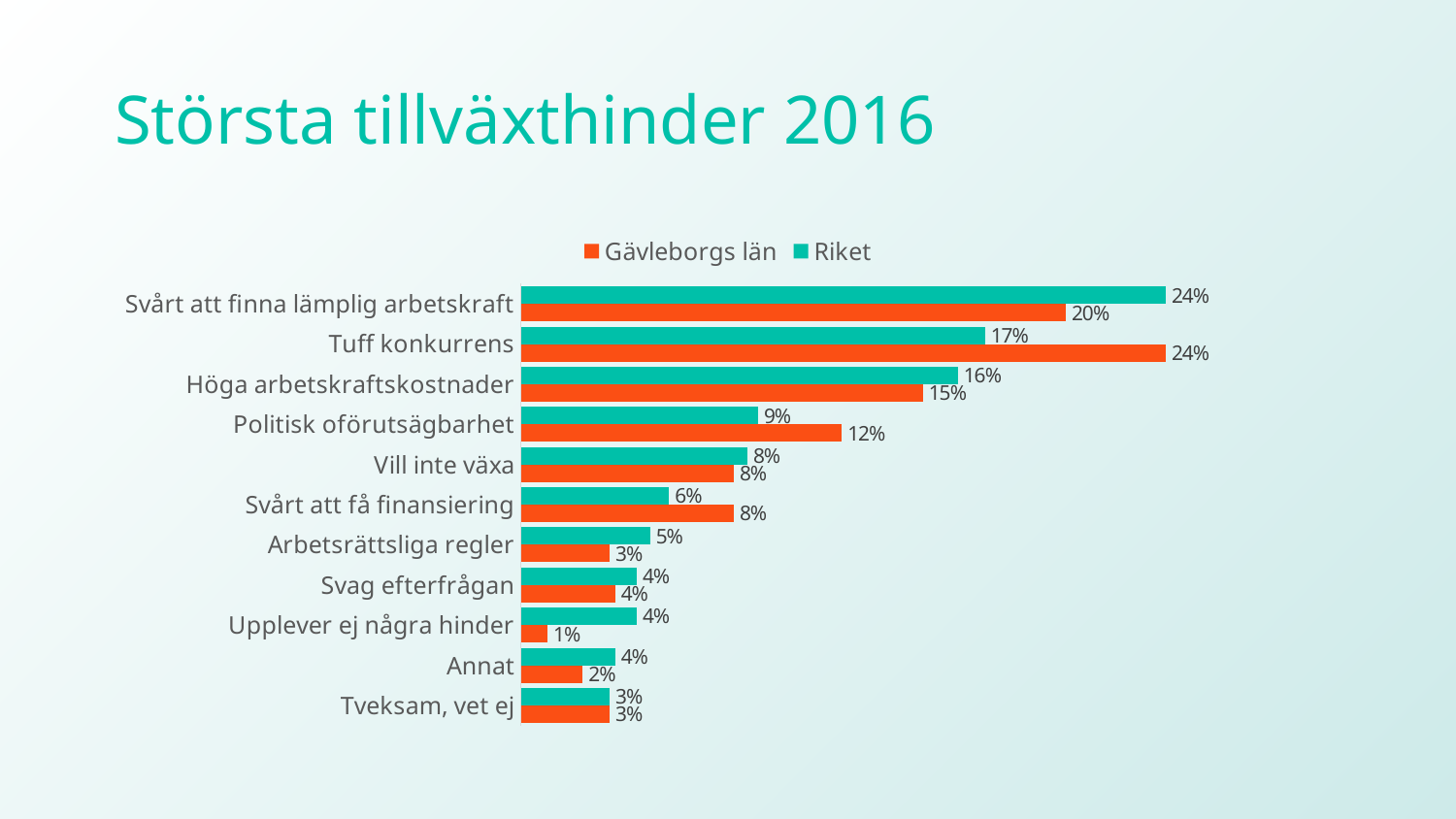
Which category has the lowest value for Gävleborgs län? Upplever ej några hinder What is the value for Gävleborgs län for "Upplever ej några hinder"? 1% For "Svårt att få finansiering", which series has the larger value, Gävleborgs län or Riket? Gävleborgs län What is the value for Riket for "Svårt att finna lämplig arbetskraft"? 24% For "Arbetsrättsliga regler", which series has the larger value, Gävleborgs län or Riket? Riket How many series does the legend list? 2 What is the difference between the Riket and Gävleborgs län values for "Svårt att finna lämplig arbetskraft"? 4% What kind of chart is shown on the slide? Bar chart What is the difference between the Gävleborgs län and Riket values for "Tuff konkurrens"? 7% How many categories are shown in the chart? 11 What is the value for Gävleborgs län for "Politisk oförutsägbarhet"? 12% Which category has the highest value for Gävleborgs län? Tuff konkurrens